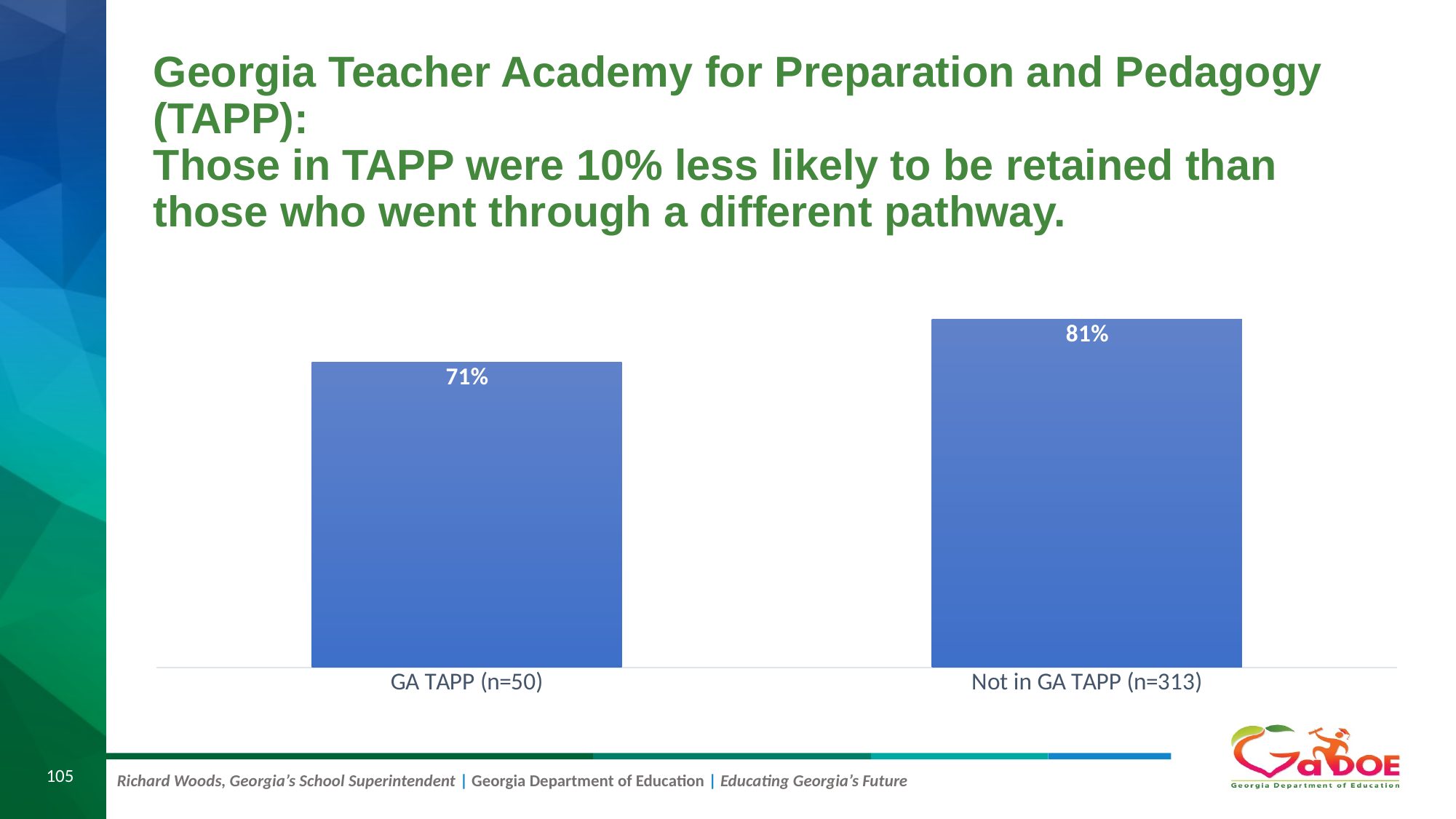
Which category has the highest value? Not in GA TAPP (n=313) What is the sample size shown in the label for the GA TAPP category? n=50 How many categories are shown in the chart? 2 What is the value for GA TAPP (n=50)? 71% What is the difference between the values for Not in GA TAPP (n=313) and GA TAPP (n=50)? 10% What is the sample size shown in the label for the Not in GA TAPP category? n=313 What is the value for Not in GA TAPP (n=313)? 81% Which category has the lowest value? GA TAPP (n=50) What kind of chart is shown on the slide? Bar chart Which is larger, the value for GA TAPP (n=50) or the value for Not in GA TAPP (n=313)? Not in GA TAPP (n=313)